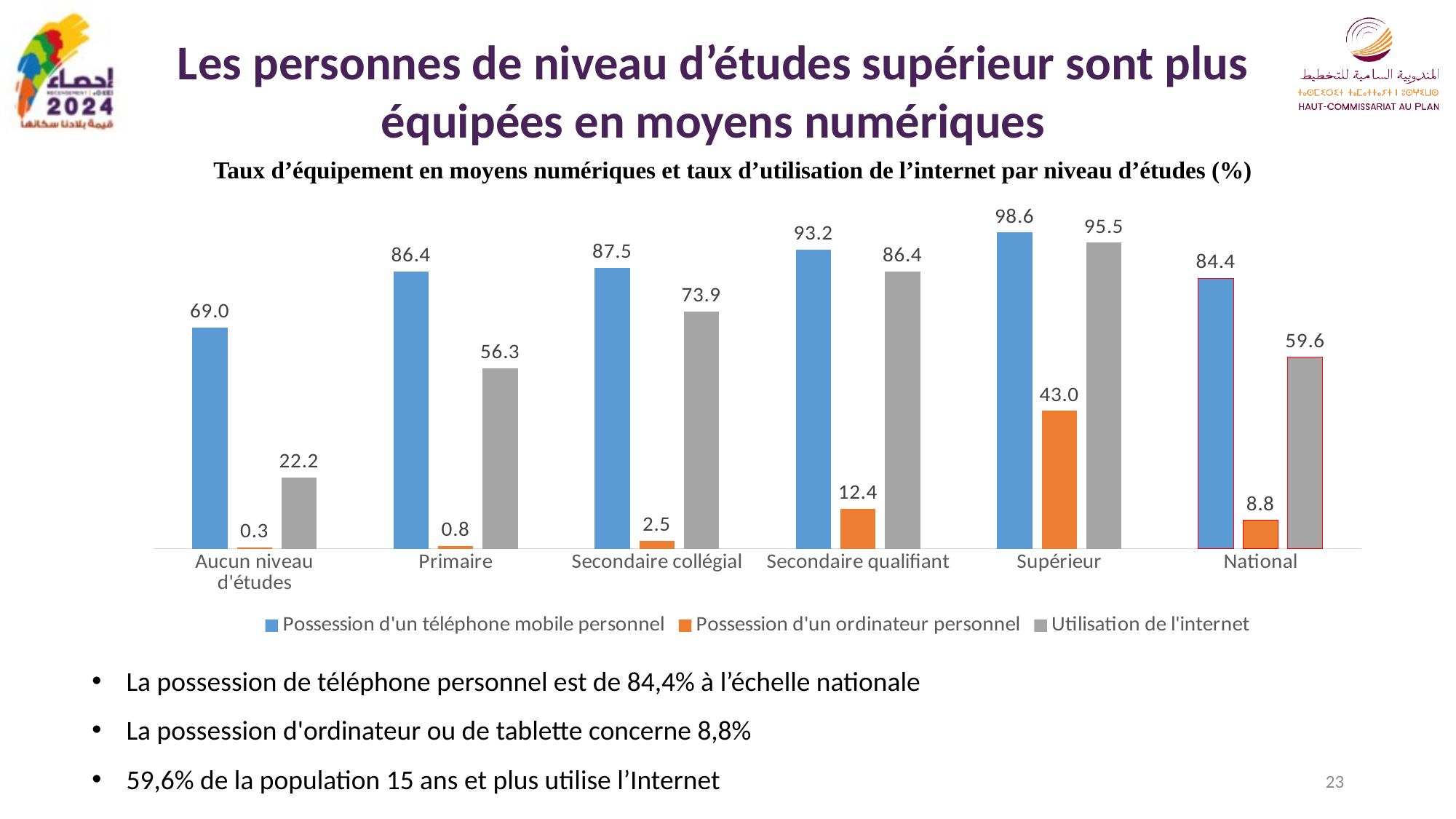
What kind of chart is shown on the slide? Bar chart What is the value for 'Possession d'un ordinateur personnel' for the 'Secondaire qualifiant' category? 12.4 Which is larger: 'Utilisation de l'internet' for 'Secondaire collégial' or for 'National'? Secondaire collégial How many categories are shown on the x axis? 6 What is the difference between the 'Possession d'un téléphone mobile personnel' values for 'Supérieur' and 'Aucun niveau d'études'? 29.6 What is the value for 'Utilisation de l'internet' for the 'Primaire' category? 56.3 Which category has the highest value for 'Utilisation de l'internet'? Supérieur Which category has the lowest value for 'Possession d'un ordinateur personnel'? Aucun niveau d'études What colour are the bars for 'Utilisation de l'internet'? Grey Do the 'Possession d'un ordinateur personnel' values rise or fall from 'Aucun niveau d'études' to 'Supérieur'? Rise How many series does the legend list? 3 What is the value for 'Possession d'un téléphone mobile personnel' for the 'Supérieur' category? 98.6